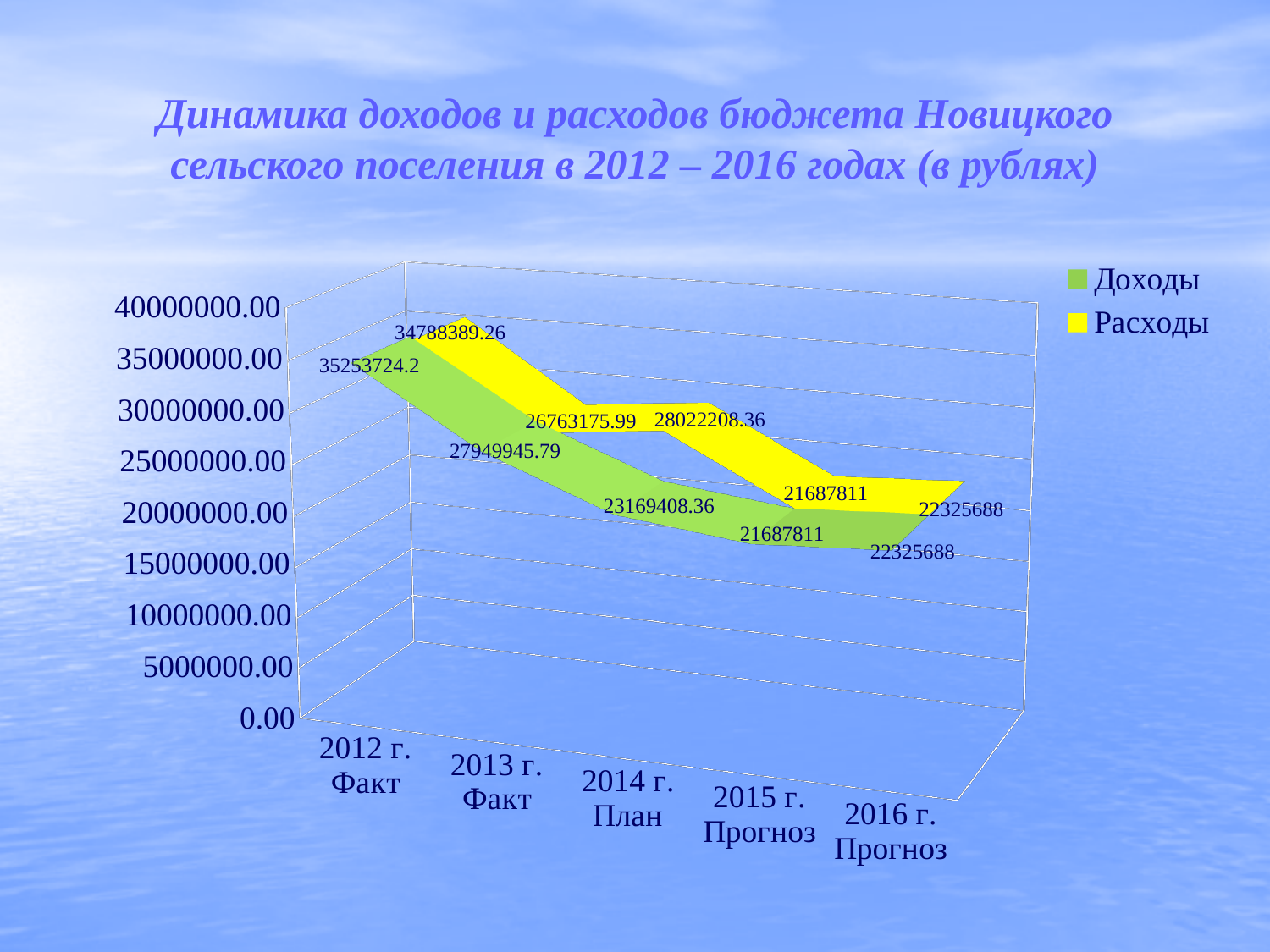
In which category is Доходы lowest? 2015 г. Прогноз Is the value of Доходы for 2014 г. План greater or less than 25000000.00? less What is the value of Доходы for 2012 г. Факт? 35253724.2 How many series does the legend list? 2 What is the value of Доходы for 2013 г. Факт? 27949945.79 In which category is Доходы highest? 2012 г. Факт What kind of chart is shown on the slide? line chart What is the value of Расходы for 2014 г. План? 28022208.36 Which is larger for 2013 г. Факт, Доходы or Расходы? Доходы What is the difference between Расходы and Доходы for 2014 г. План? 4852800 How many categories are shown on the x axis? 5 What is the value of Расходы for 2016 г. Прогноз? 22325688